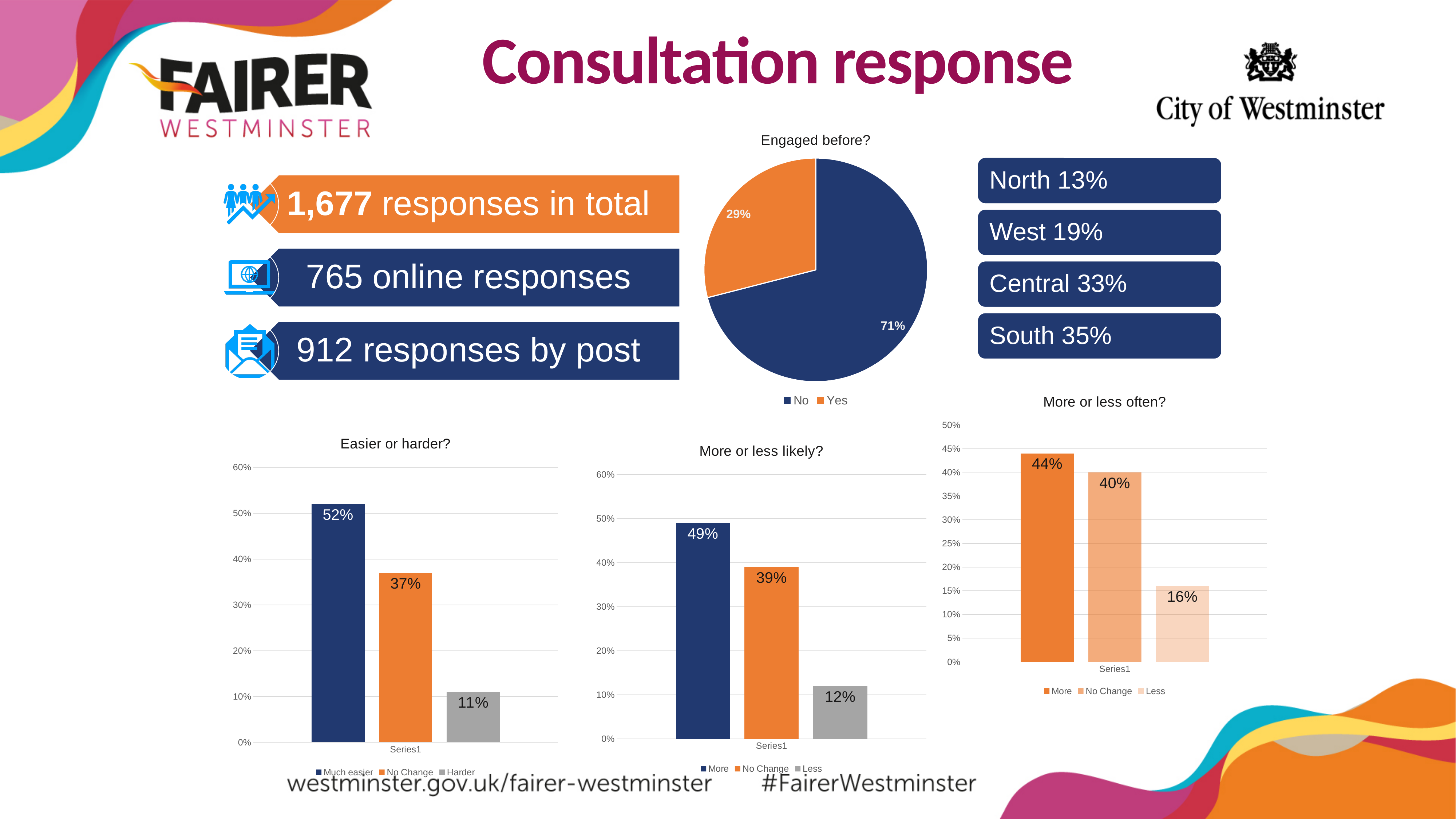
What kind of chart is 'Engaged before?'? pie chart In the 'Easier or harder?' chart, what is the value for Much easier? 52% In the 'More or less often?' chart, what is the value for Less? 16% In the 'Easier or harder?' chart, which category has the lowest value? Harder In the 'More or less likely?' chart, which category has the highest value? More In the 'More or less likely?' chart, what is the value for No Change? 39% What kind of chart is 'More or less often?'? bar chart In the 'More or less likely?' chart, how many series does the legend list? 3 In the 'Engaged before?' pie chart, what share of respondents answered No? 71% In the 'More or less often?' chart, which is larger, More or No Change? More In the 'Easier or harder?' chart, what is the difference between Much easier and No Change? 15% In the 'Engaged before?' pie chart, what share of respondents answered Yes? 29%